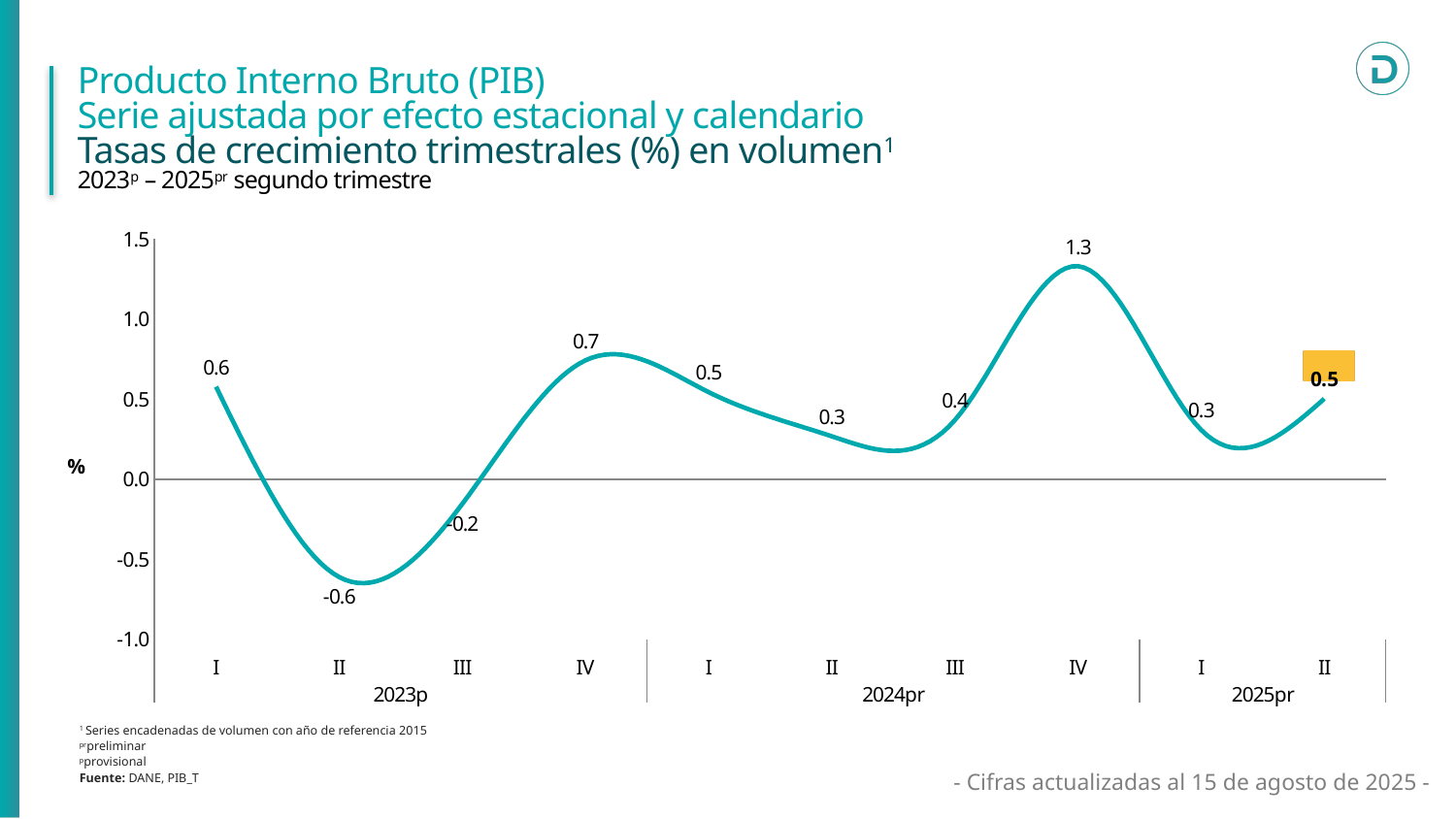
What kind of chart is shown on the slide? Line chart What is the quarterly growth rate for the fourth quarter (IV) of 2024pr? 1.3 Which quarter has the highest growth rate on the chart? IV 2024pr What is the unit shown on the vertical axis of the chart? % What is the difference between the growth rate in IV 2024pr and I 2025pr? 1.0 What is the quarterly growth rate for the second quarter (II) of 2023p? -0.6 Which is larger, the growth rate in IV 2023p or in I 2024pr? IV 2023p How many quarters show a negative growth rate? 2 Which quarter has the lowest growth rate on the chart? II 2023p What is the quarterly growth rate for the second quarter (II) of 2025pr? 0.5 Does the growth rate rise or fall from I 2023p to II 2023p? Fall How many quarters are plotted on the chart? 10